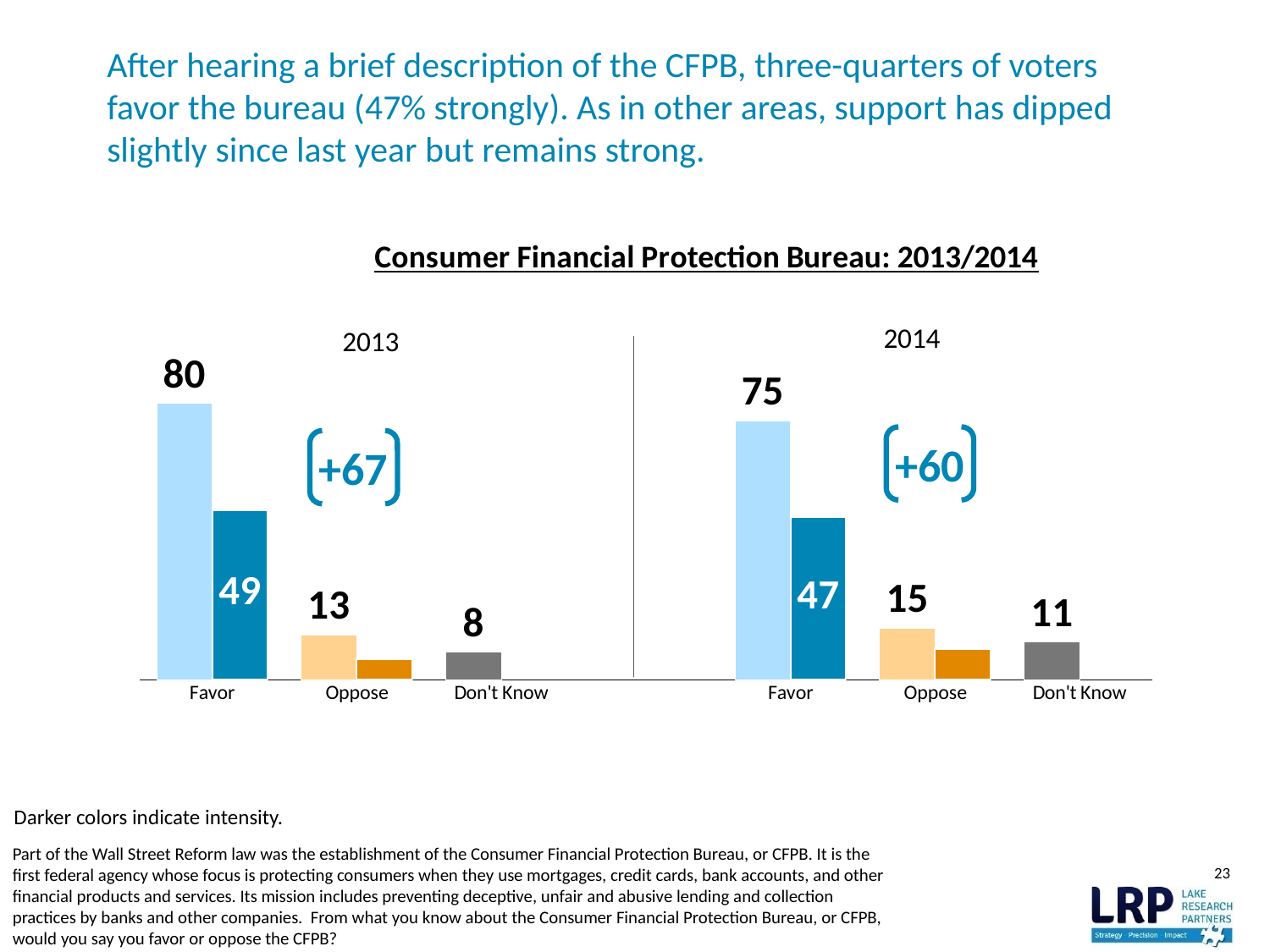
What net figure is shown in brackets on the 2014 chart? +60 In the 2013 chart, what is the value for Oppose? 13 Which is larger: the Oppose value in the 2013 chart or the Oppose value in the 2014 chart? 2014 In the 2014 chart, what is the value labeled on the darker Favor bar (strongly favor)? 47 In the 2013 chart, which category has the lowest value? Don't Know How many categories are shown on the x axis of the 2013 chart? 3 What is the difference between the Favor value in the 2013 chart and the Favor value in the 2014 chart? 5 In the 2013 chart, what is the value for Favor? 80 What kind of chart is used for the 2014 data? Bar chart In the 2014 chart, what is the value for Favor? 75 In the 2014 chart, what is the value for Don't Know? 11 In the 2014 chart, which category has the highest value? Favor